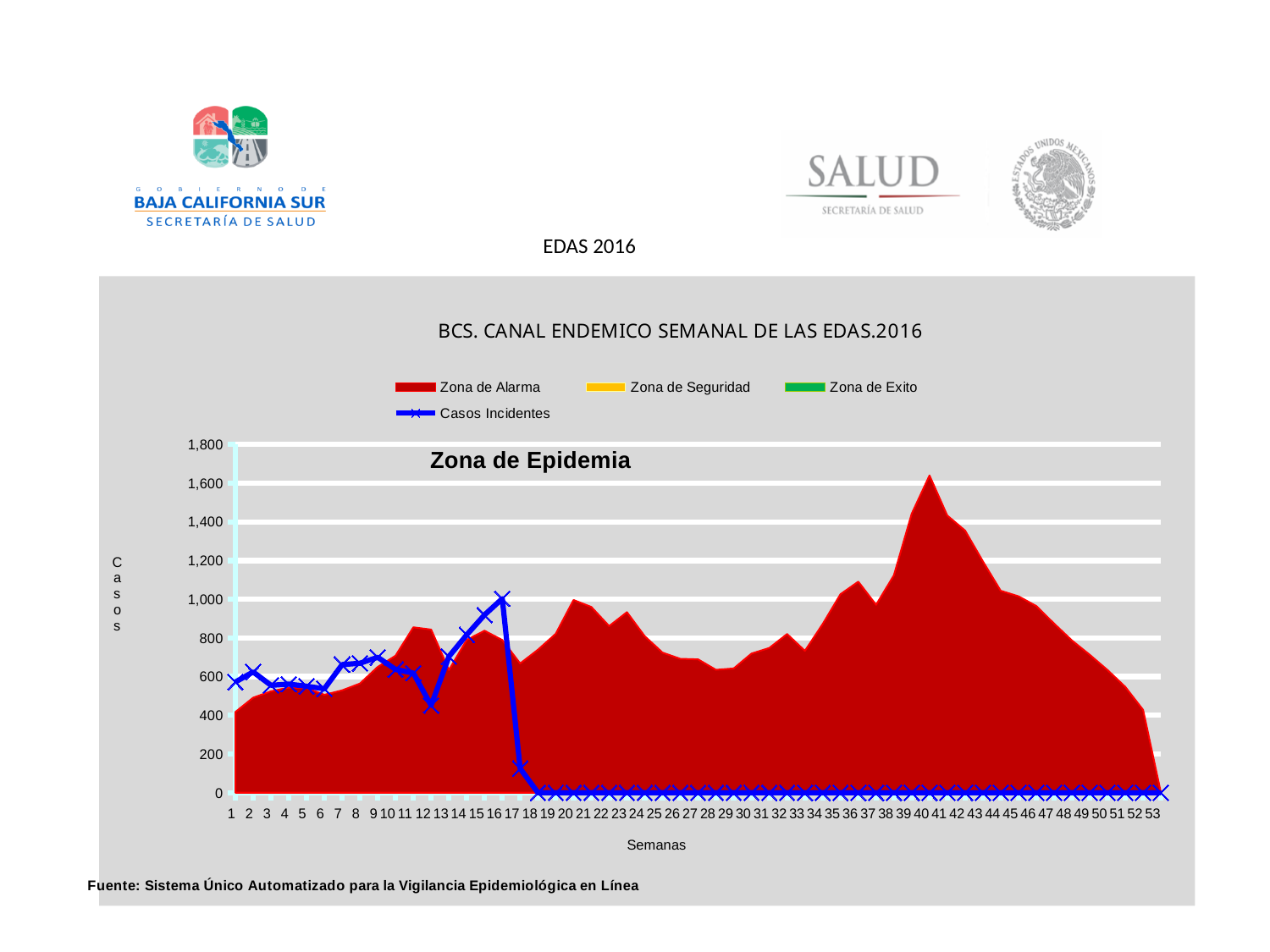
Is the value of Casos Incidentes at week 12 greater or less than 600? less In which week does the Zona de Alarma area reach its highest value? 40 Which is larger, the Zona de Alarma value at week 40 or at week 20? week 40 How many series does the chart legend list? 4 Is the value of Zona de Alarma at week 40 greater or less than 1,400? greater What is the title of the chart? BCS. CANAL ENDEMICO SEMANAL DE LAS EDAS.2016 In which week does the Casos Incidentes line reach its highest value? 16 Does the Casos Incidentes line rise or fall between week 16 and week 19? fall How many weeks are shown on the x axis of the chart? 53 What is the label of the x axis? Semanas What is the value of Casos Incidentes at week 30? 0 Is the value of Casos Incidentes at week 16 greater or less than 800? greater